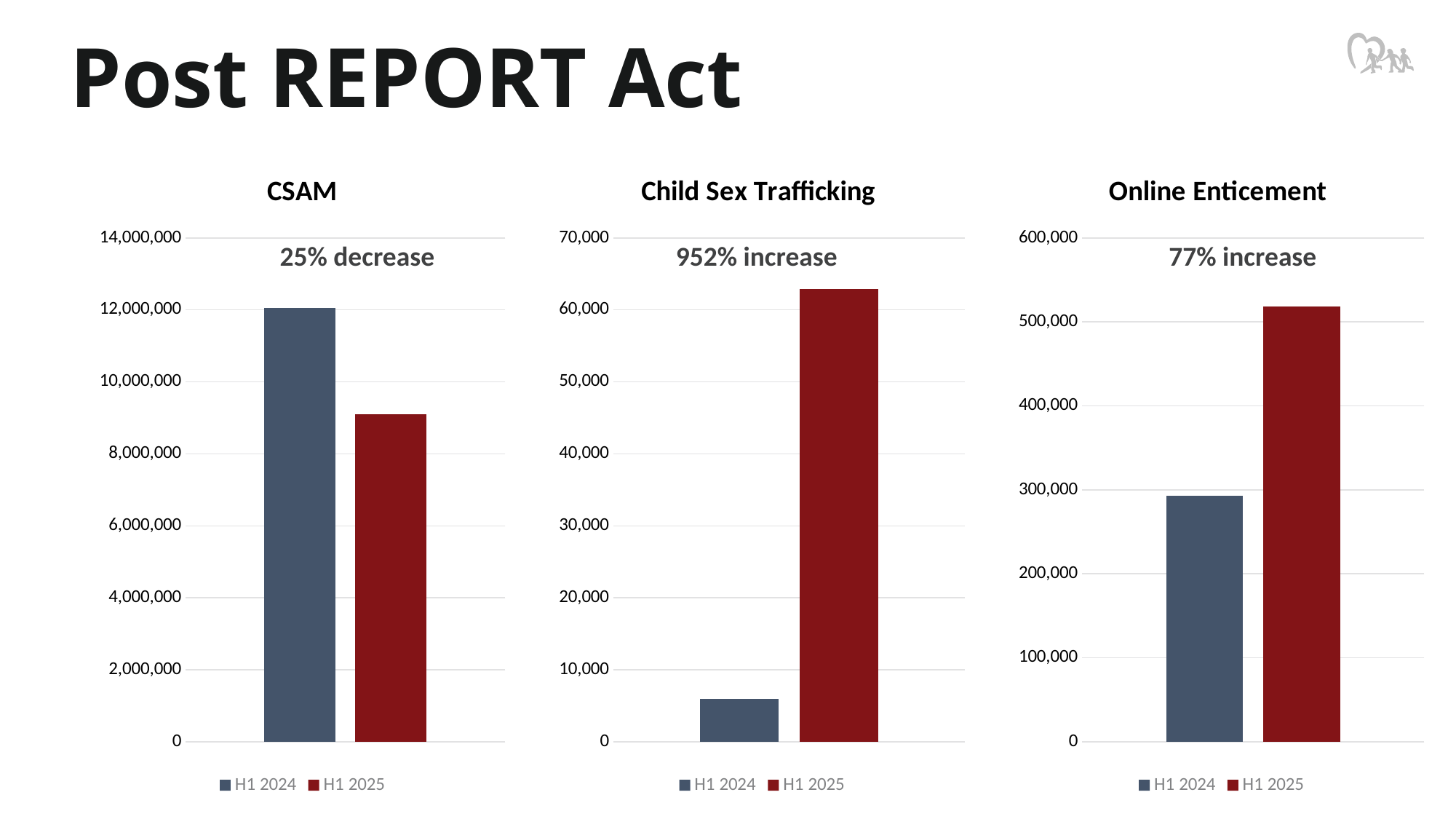
In the CSAM chart, which is larger, H1 2024 or H1 2025? H1 2024 In the Online Enticement chart, is the value for H1 2024 greater or less than 300,000? less How many series does the legend of the Child Sex Trafficking chart list? 2 What percentage change is annotated on the Child Sex Trafficking chart? 952% increase In the Online Enticement chart, is the value for H1 2025 greater or less than 500,000? greater In the Child Sex Trafficking chart, is the value for H1 2024 greater or less than 10,000? less What kind of chart is the CSAM chart? bar chart In the Online Enticement chart, which is larger, H1 2024 or H1 2025? H1 2025 In the Child Sex Trafficking chart, which bar is the highest? H1 2025